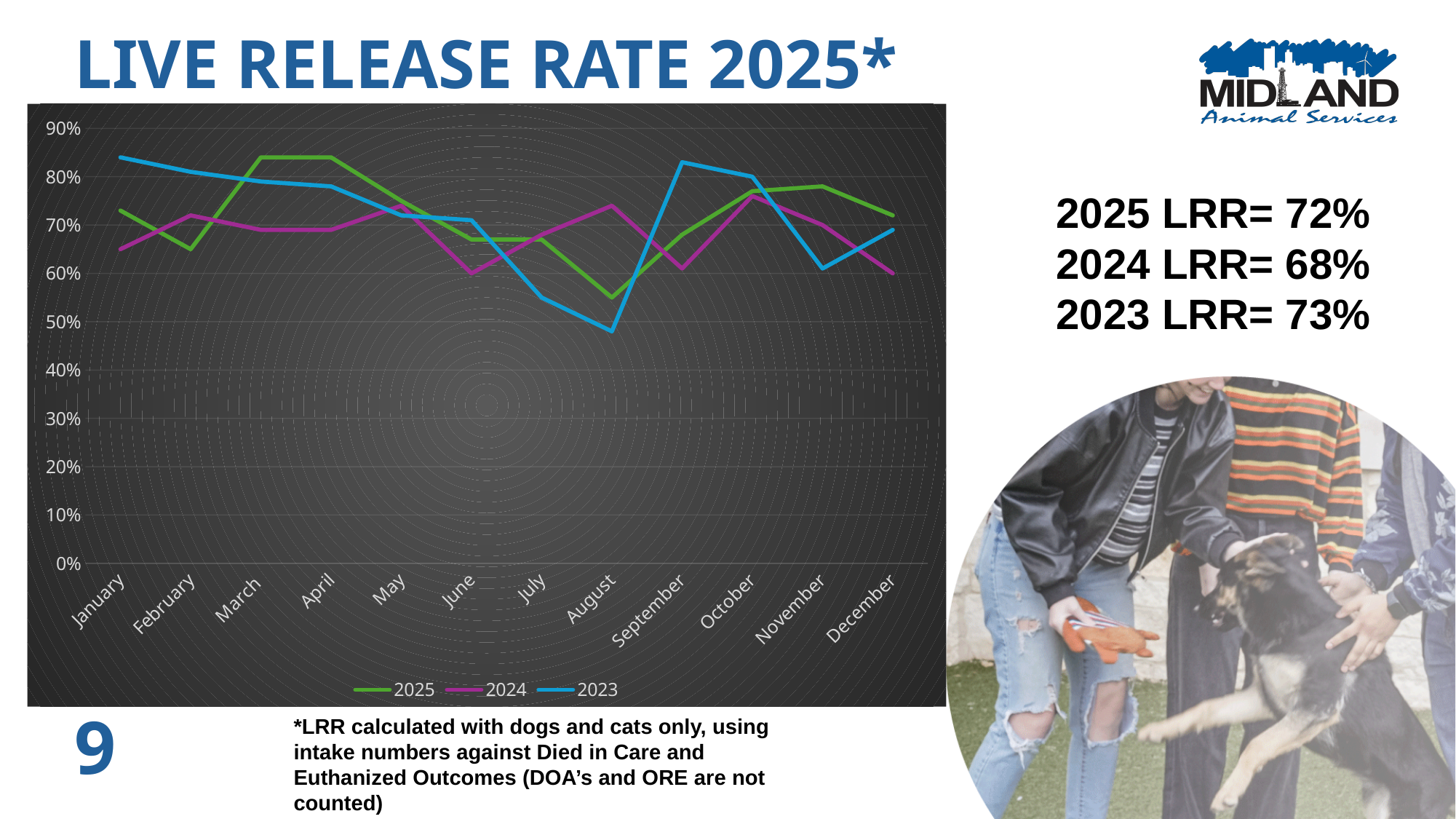
In which month is the 2023 series at its lowest? August What colour is the 2025 line in the chart? Green Is the 2023 value for August greater or less than 60%? less Is the 2024 value for June greater or less than 70%? less What kind of chart is shown on the slide? Line chart How many months are plotted along the x axis? 12 In January, which series has the higher value, 2023 or 2024? 2023 Is the 2025 value for March greater or less than 80%? greater Does the 2023 series rise or fall from January to April? Fall How many series does the chart legend list? 3 In which month is the 2025 series at its lowest? August